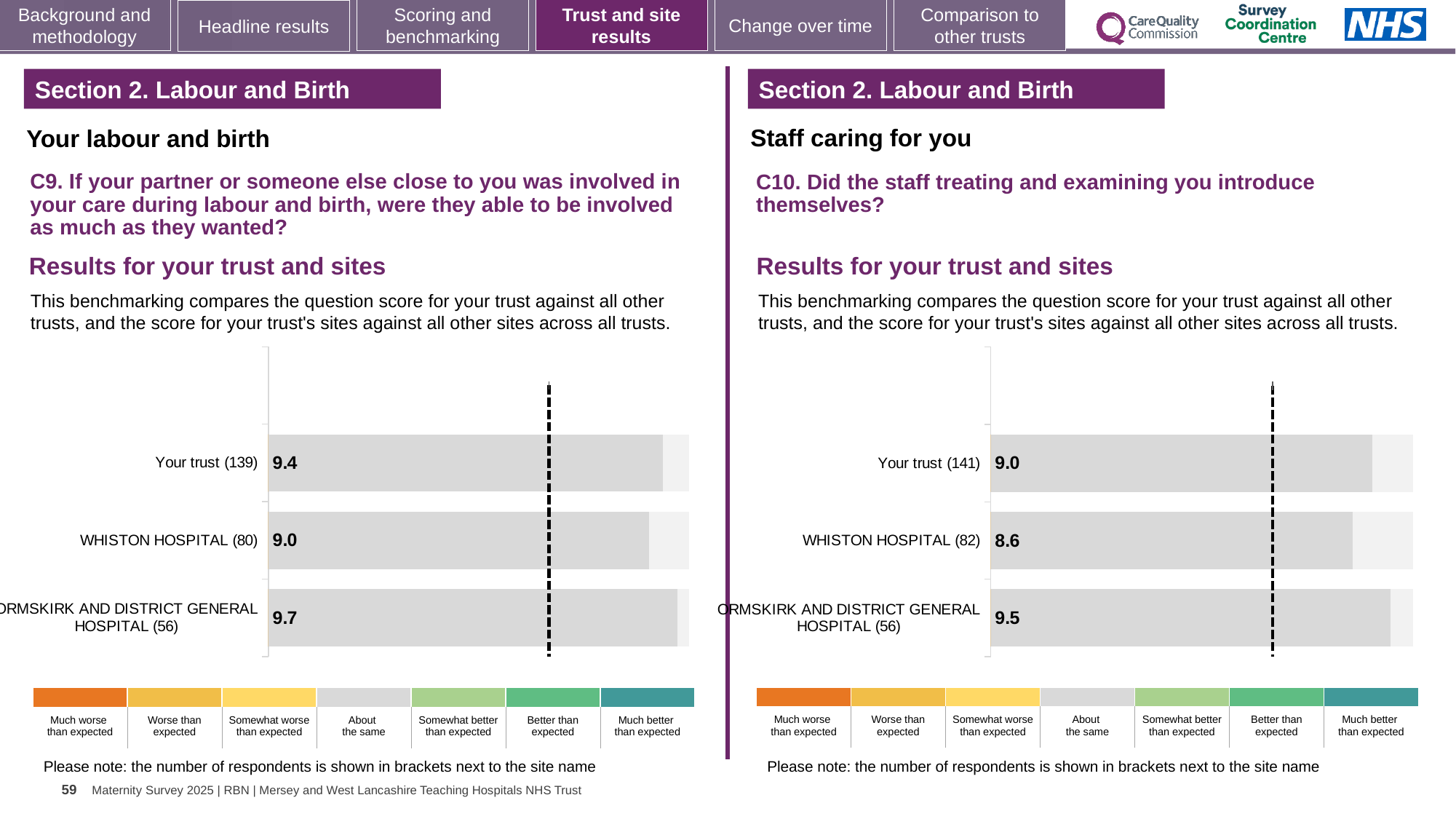
On the right chart (C10), which is larger: the score for Your trust or the score for WHISTON HOSPITAL? Your trust On the right chart (C10), what is the score for WHISTON HOSPITAL? 8.6 On the right chart (C10), what is the score for ORMSKIRK AND DISTRICT GENERAL HOSPITAL? 9.5 On the left chart (C9), what is the score for WHISTON HOSPITAL? 9.0 On the right chart (C10), what is the difference between the scores for Your trust and WHISTON HOSPITAL? 0.4 On the left chart (C9), what is the score for Your trust? 9.4 On the right chart (C10), how many respondents are shown in brackets for Your trust? 141 On the left chart (C9), which site or trust has the highest score? ORMSKIRK AND DISTRICT GENERAL HOSPITAL What kind of chart is used on the left (C9) to show the results for the trust and sites? Bar chart On the right chart (C10), which site or trust has the lowest score? WHISTON HOSPITAL On the left chart (C9), how many bars are plotted? 3 On the left chart (C9), what is the difference between the scores for ORMSKIRK AND DISTRICT GENERAL HOSPITAL and WHISTON HOSPITAL? 0.7